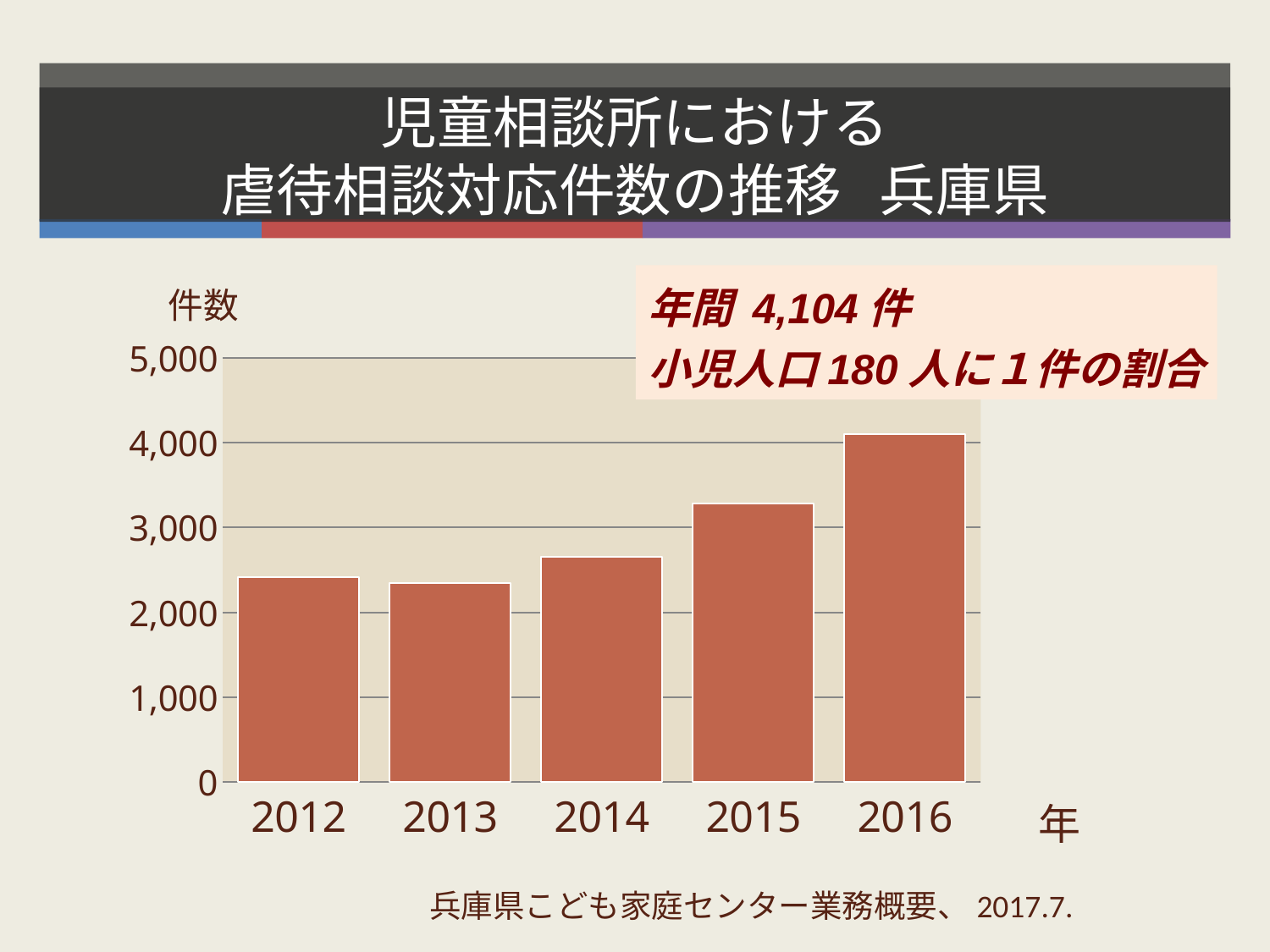
Is the value for 2015 greater or less than 3,000? greater What is the label on the horizontal axis of the chart? 年 Do the values generally rise or fall from 2012 to 2016? rise How many years are plotted on the x axis of the chart? 5 Is the value for 2016 greater or less than 4,000? greater Which year has the highest number of cases in the chart? 2016 Which year has the larger value, 2012 or 2016? 2016 Is the value for 2012 greater or less than 3,000? less Which year has the larger value, 2014 or 2015? 2015 What kind of chart is shown on the slide? bar chart What is the label on the vertical axis of the chart? 件数